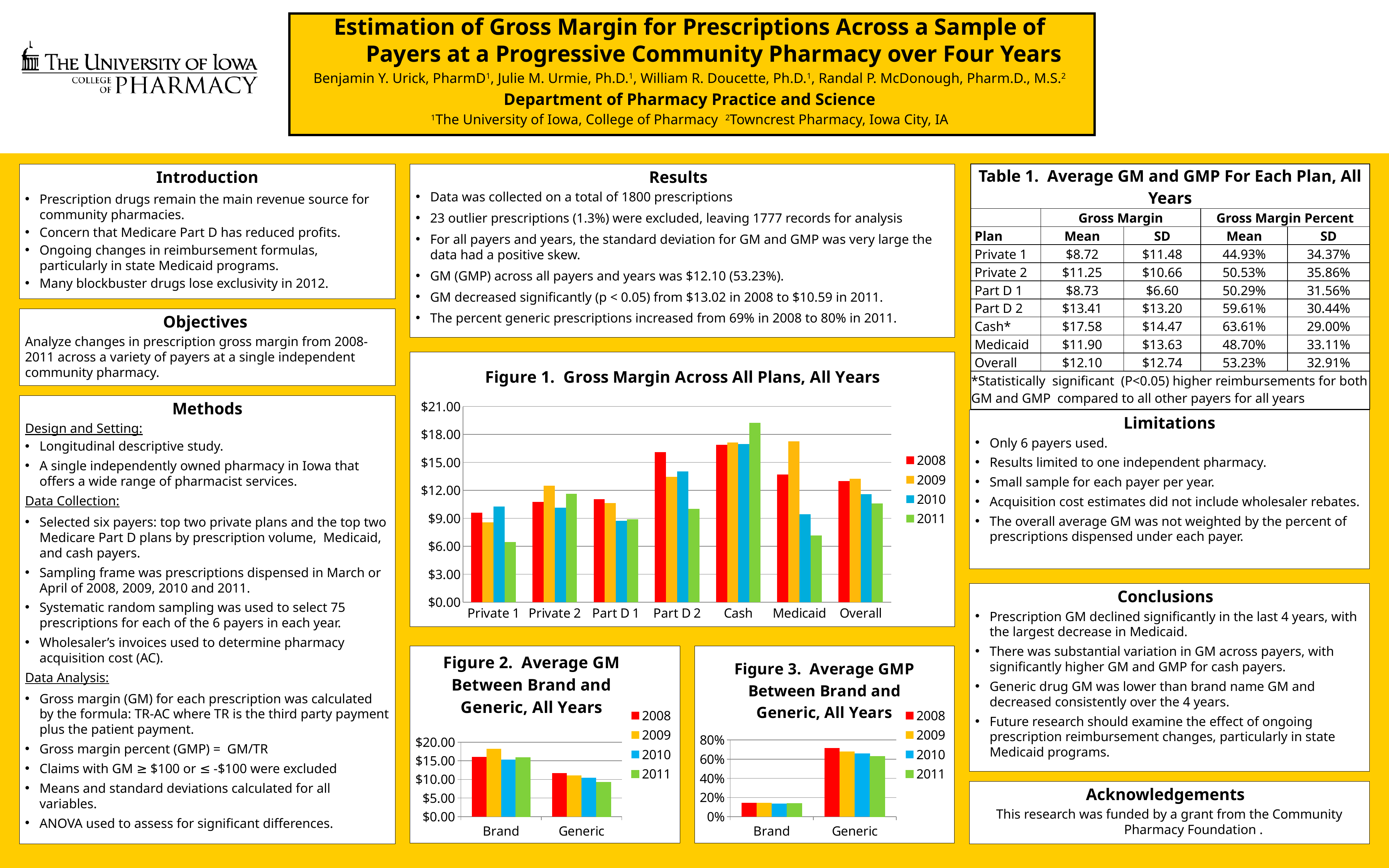
In Figure 1 (Gross Margin Across All Plans, All Years), is the 2011 value for Cash greater or less than $18.00? greater In Figure 1 (Gross Margin Across All Plans, All Years), is the 2008 value for Part D 2 greater or less than $15.00? greater In Figure 3 (Average GMP Between Brand and Generic, All Years), is the 2008 value for Generic greater or less than 60%? greater In Figure 1 (Gross Margin Across All Plans, All Years), which is larger for Medicaid: the 2009 value or the 2010 value? 2009 In Figure 2 (Average GM Between Brand and Generic, All Years), which year has the highest Brand value? 2009 In Figure 3 (Average GMP Between Brand and Generic, All Years), which category has the higher values: Brand or Generic? Generic What kind of chart is Figure 1 (Gross Margin Across All Plans, All Years)? Bar chart In Figure 1 (Gross Margin Across All Plans, All Years), how many series does the legend list? 4 In Figure 2 (Average GM Between Brand and Generic, All Years), do the Generic values rise or fall from 2008 to 2011? fall In Figure 1 (Gross Margin Across All Plans, All Years), which plan has the tallest bar for 2011? Cash In Figure 1 (Gross Margin Across All Plans, All Years), how many plan categories are shown on the x axis? 7